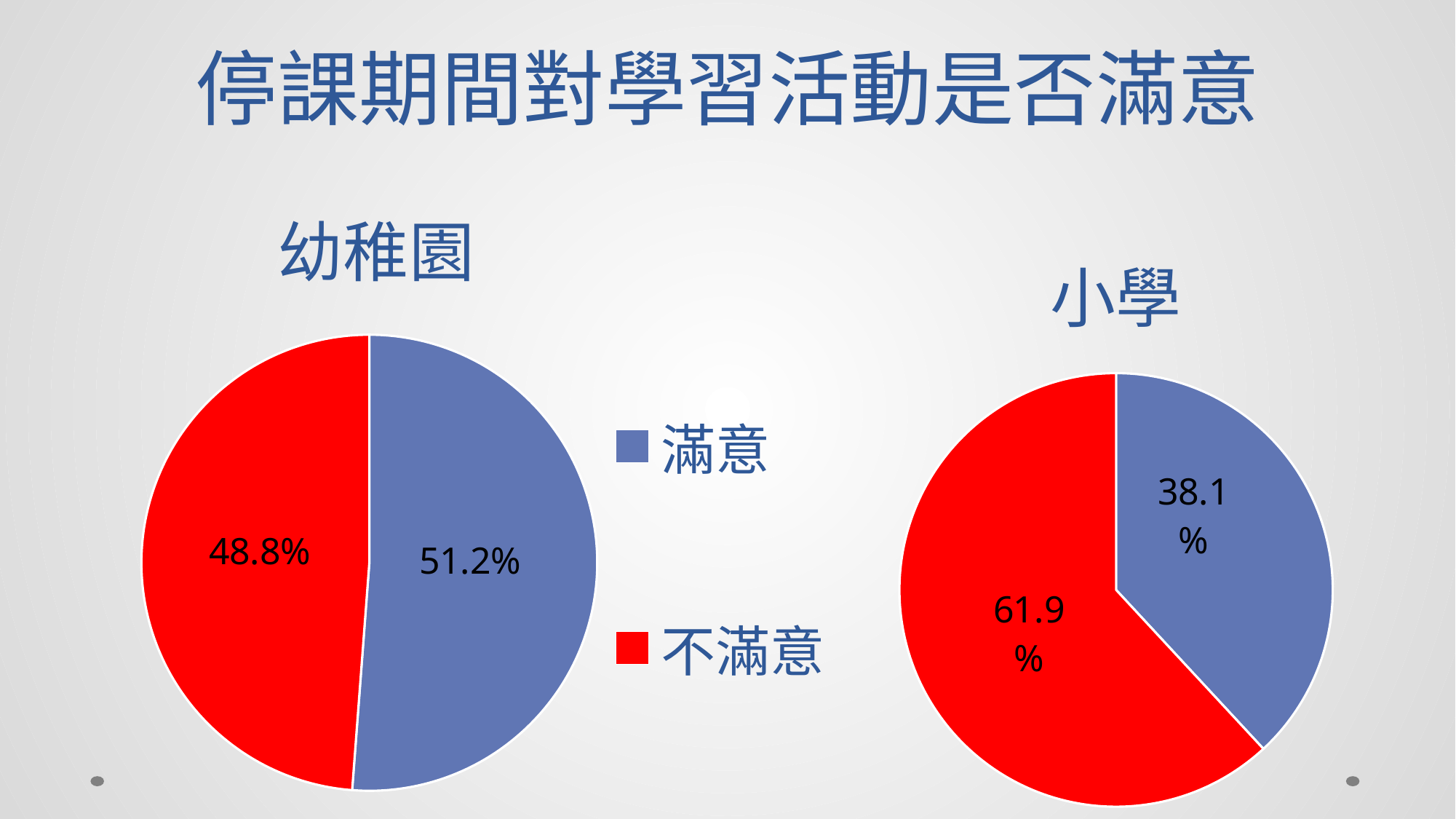
What colour represents 不滿意 in the legend? Red How many slices does the 小學 pie chart have? 2 In the 小學 pie chart, what percentage is 不滿意? 61.9% In the 小學 pie chart, which slice is the largest? 不滿意 Is the 滿意 share larger in the 幼稚園 chart or the 小學 chart? 幼稚園 In the 幼稚園 pie chart, what is the difference between 滿意 and 不滿意? 2.4% In the 幼稚園 pie chart, which slice is the smallest? 不滿意 What kind of chart is used for 幼稚園? Pie chart In the 小學 pie chart, what percentage is 滿意? 38.1% In the 幼稚園 pie chart, what percentage is 滿意? 51.2% In the 幼稚園 pie chart, what percentage is 不滿意? 48.8% In the 小學 pie chart, what is the difference between 不滿意 and 滿意? 23.8%